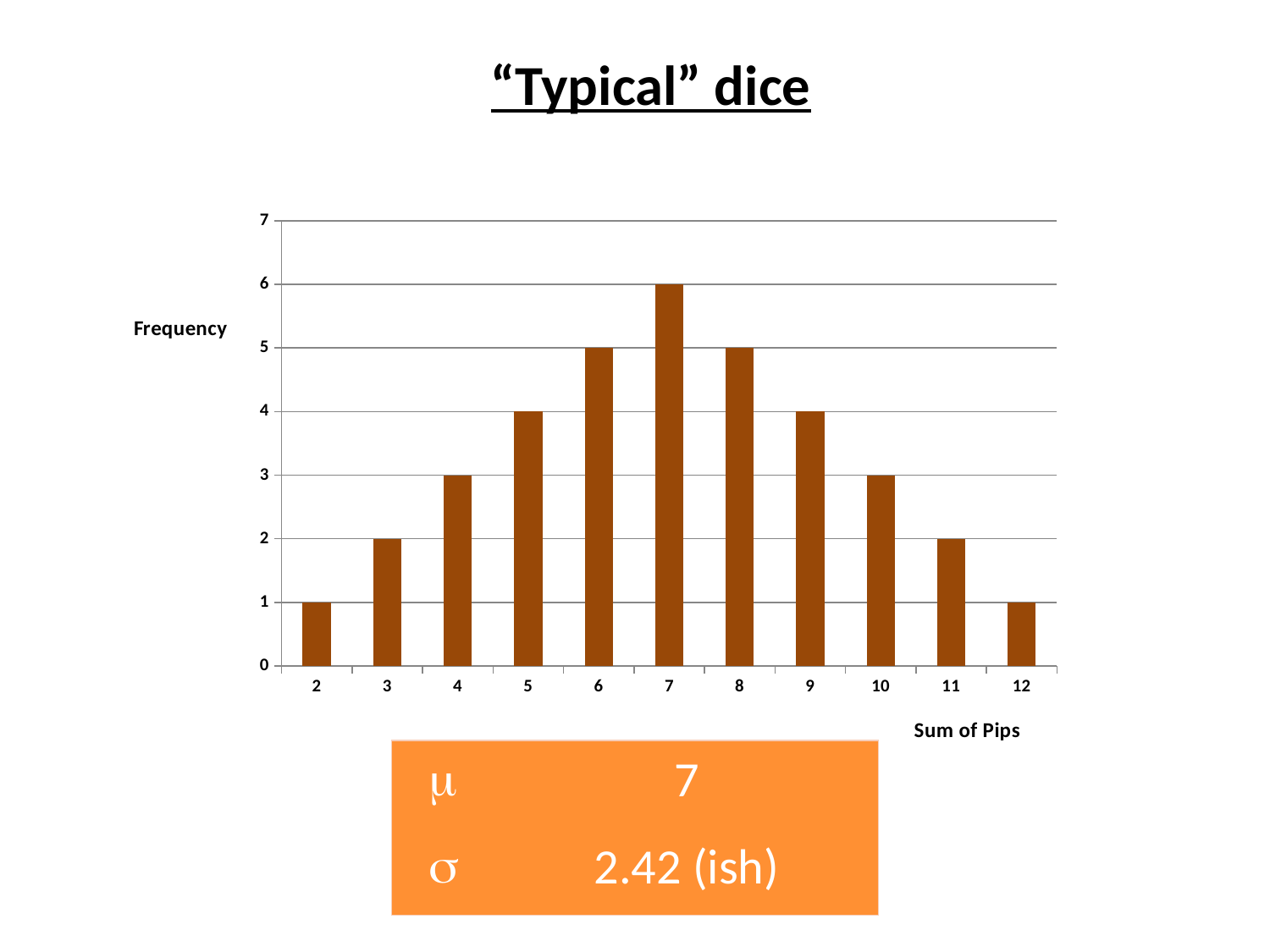
Which sum of pips has the highest frequency? 7 What kind of chart is shown on the slide? bar chart What is the frequency for a sum of pips of 4? 3 What is the frequency for a sum of pips of 12? 1 Do the frequencies rise or fall as the sum of pips goes from 7 to 12? fall What is the frequency for a sum of pips of 7? 6 What is the label of the x axis? Sum of Pips Which has a higher frequency, a sum of pips of 5 or a sum of pips of 11? 5 Do the frequencies rise or fall as the sum of pips goes from 2 to 7? rise What is the difference in frequency between a sum of 7 and a sum of 2? 5 How many sum-of-pips categories are plotted on the x axis? 11 What is the title of the slide? "Typical" dice